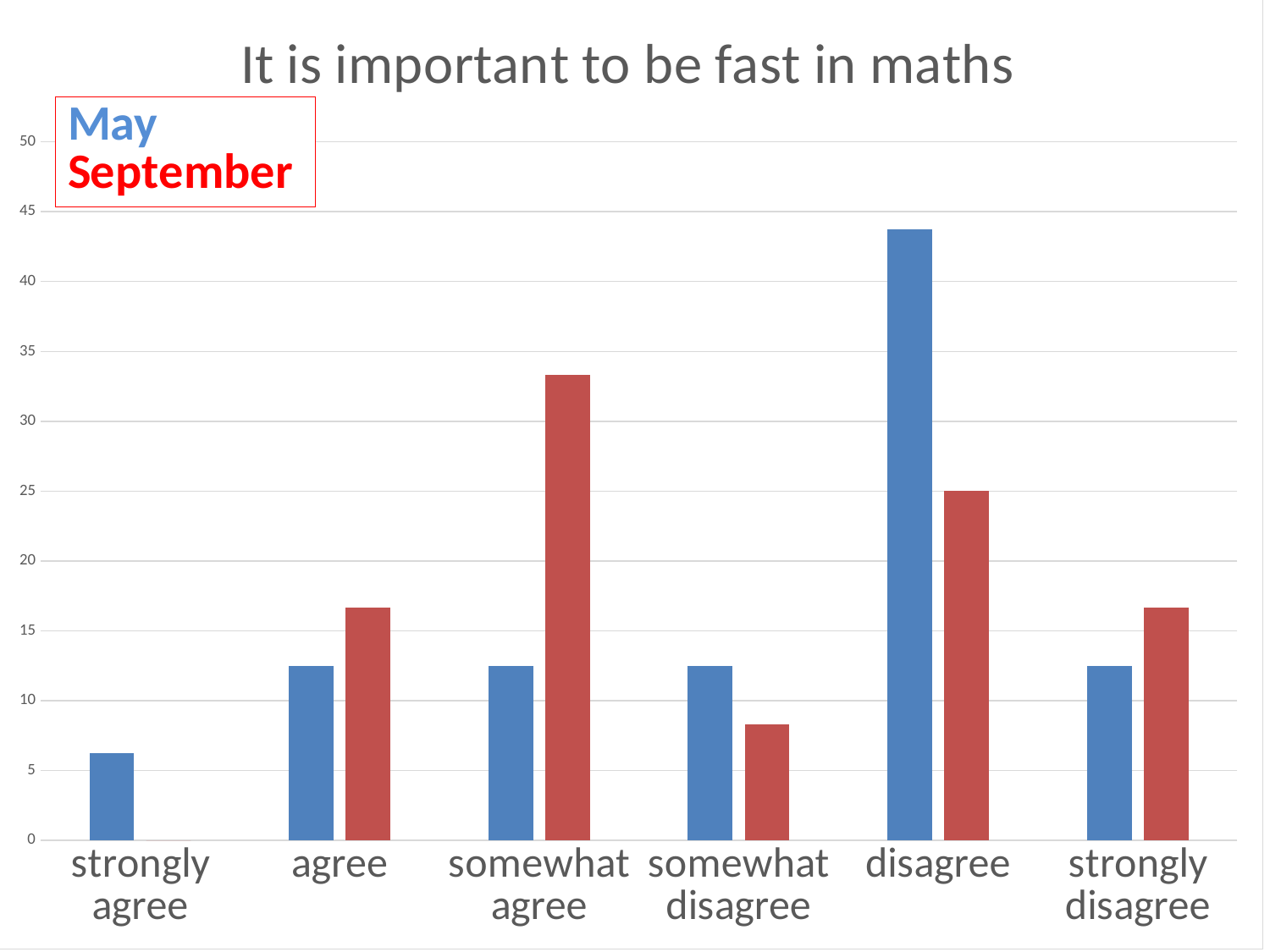
Which category has the lowest May value? strongly agree Is the September value for somewhat agree greater or less than 30? greater What kind of chart is shown on the slide? bar chart What is the title of the chart? It is important to be fast in maths For somewhat agree, which is larger, the May value or the September value? September Is the May value for disagree greater or less than 40? greater How many categories are shown on the x axis? 6 How many series does the legend list? 2 Which category has the highest May value? disagree For somewhat disagree, which is larger, the May value or the September value? May Is the May value for strongly agree greater or less than 10? less Which category has the highest September value? somewhat agree